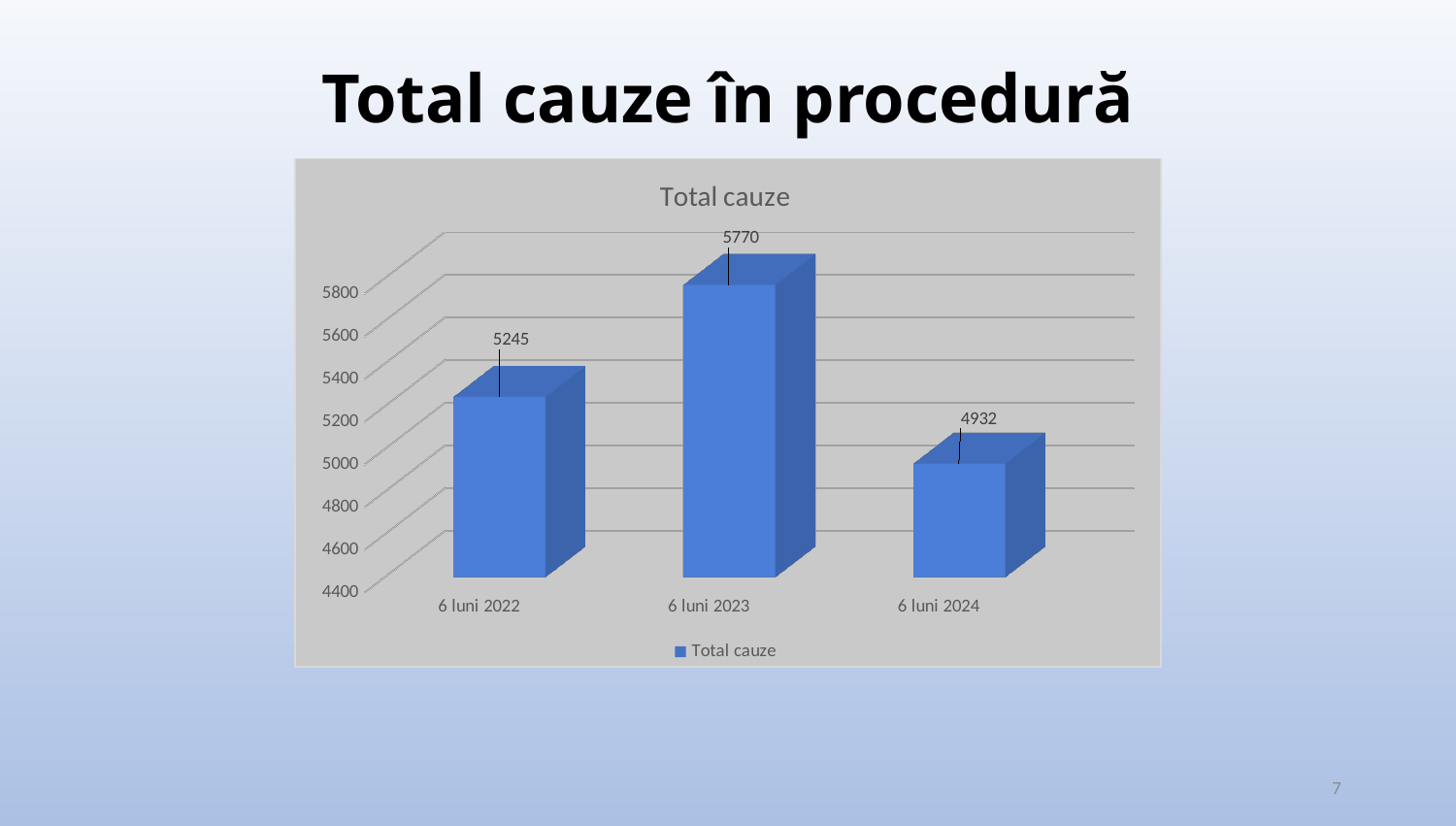
What is the value for 6 luni 2022? 5245 What is the difference between the values for 6 luni 2022 and 6 luni 2024? 313 What is the title of the chart? Total cauze What is the difference between the values for 6 luni 2023 and 6 luni 2022? 525 What is the value for 6 luni 2023? 5770 Which category has the highest value? 6 luni 2023 How many categories are shown on the x axis? 3 Which category has the lowest value? 6 luni 2024 Is the value for 6 luni 2024 greater or less than 5000? less What is the value for 6 luni 2024? 4932 Which is larger, the value for 6 luni 2022 or the value for 6 luni 2024? 6 luni 2022 What kind of chart is shown on the slide? bar chart